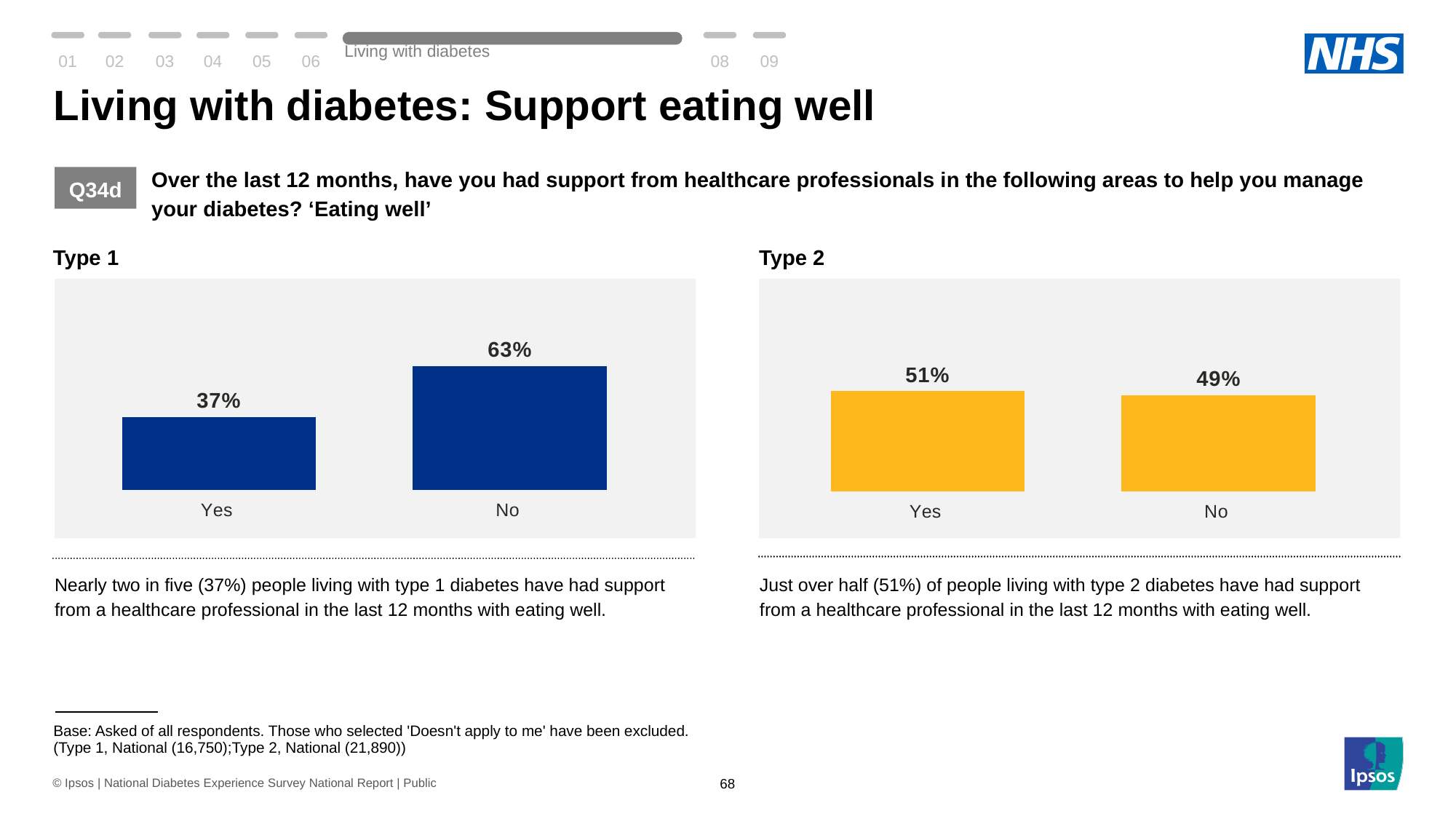
In the Type 1 chart, which category has the highest value? No In the Type 1 chart, what percentage of respondents answered Yes? 37% In the Type 2 chart, what is the difference between the Yes and No values? 2 percentage points In the Type 2 chart, what percentage of respondents answered Yes? 51% What colour are the bars in the Type 2 chart? Yellow How many categories are shown in the Type 1 chart? 2 In the Type 2 chart, what percentage of respondents answered No? 49% In the Type 2 chart, which category has the lowest value? No In the Type 1 chart, what percentage of respondents answered No? 63% Is the Yes value larger in the Type 1 chart or the Type 2 chart? Type 2 In the Type 1 chart, what is the difference between the No and Yes values? 26 percentage points What kind of chart is the Type 2 chart? Bar chart